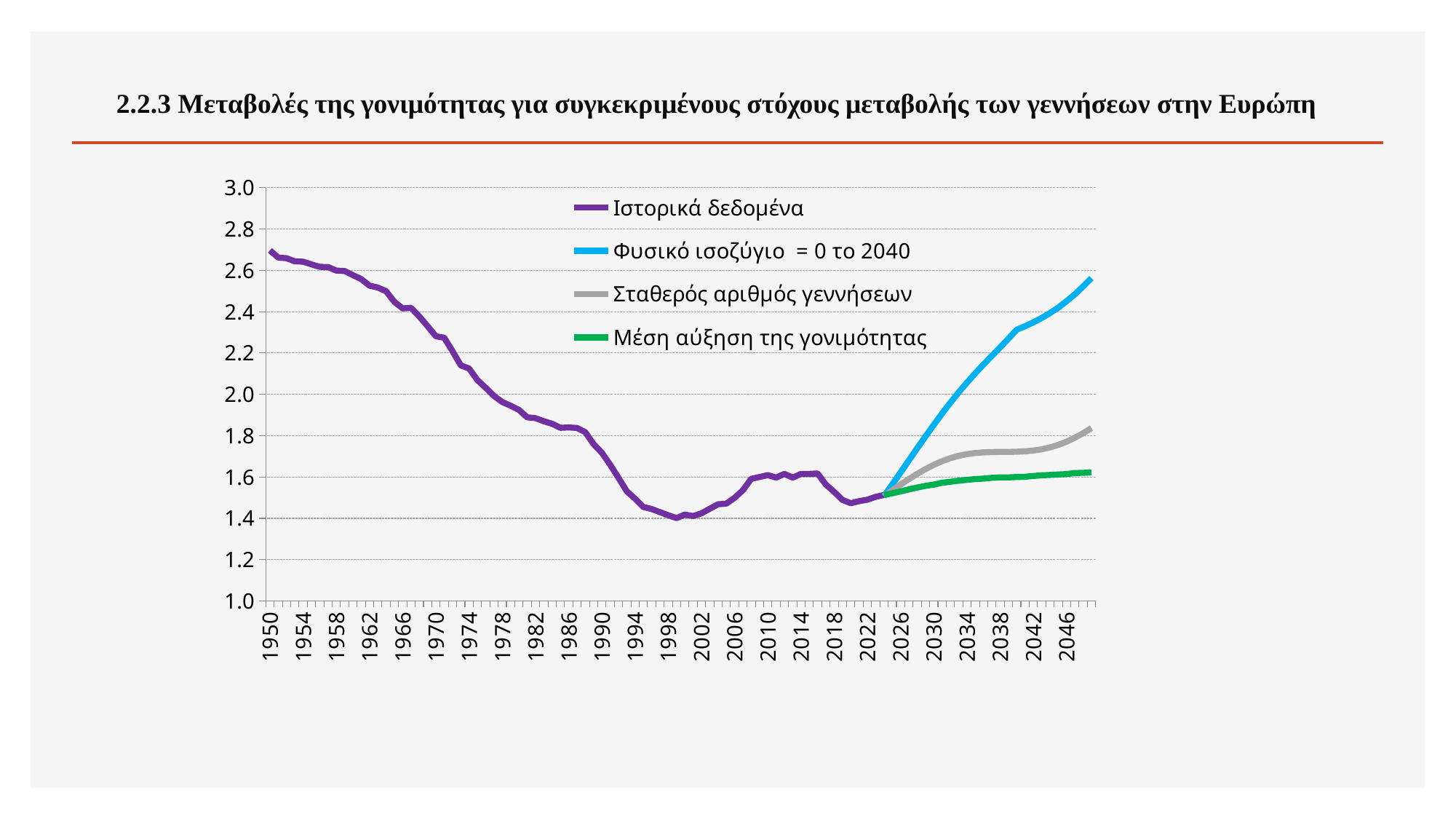
Does the Ιστορικά δεδομένα series rise or fall between 1950 and 1998? fall Does the Φυσικό ισοζύγιο = 0 το 2040 series rise or fall from 2022 onwards? rise Is the final value of the Μέση αύξηση της γονιμότητας series greater or less than 1.8? less What kind of chart is shown on the slide? line chart Is the value of Ιστορικά δεδομένα in 1950 greater or less than 2.6? greater Which series is drawn in green? Μέση αύξηση της γονιμότητας How many series does the legend list? 4 Which is larger for Ιστορικά δεδομένα: the value in 1950 or the value in 2022? 1950 Is the final value of the Φυσικό ισοζύγιο = 0 το 2040 series greater or less than 2.4? greater Which series is higher in 2046: Φυσικό ισοζύγιο = 0 το 2040 or Σταθερός αριθμός γεννήσεων? Φυσικό ισοζύγιο = 0 το 2040 Which series is drawn in purple? Ιστορικά δεδομένα